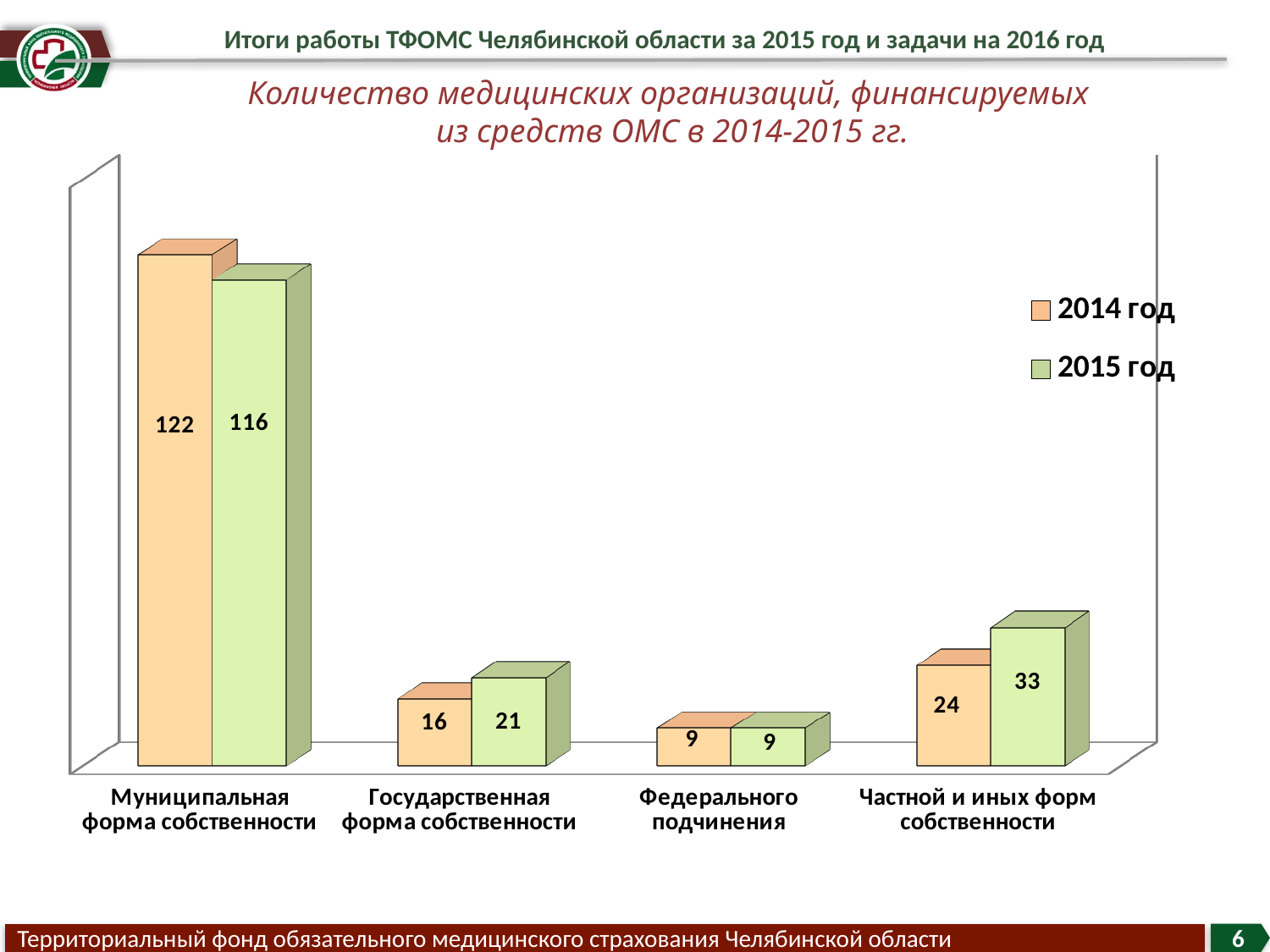
Which category has the lowest value in 2014 год? Федерального подчинения How many series does the legend list? 2 What is the difference between the 2015 год and 2014 год values for Частной и иных форм собственности? 9 What kind of chart is shown on the slide? bar chart Which is larger for Государственная форма собственности: the 2014 год value or the 2015 год value? 2015 год Which category has the highest value in 2015 год? Муниципальная форма собственности What is the value for Частной и иных форм собственности in 2015 год? 33 What is the difference between the 2014 год and 2015 год values for Муниципальная форма собственности? 6 What is the value for Государственная форма собственности in 2015 год? 21 How many categories are shown on the x axis? 4 What is the value for Муниципальная форма собственности in 2014 год? 122 What is the value for Федерального подчинения in 2015 год? 9